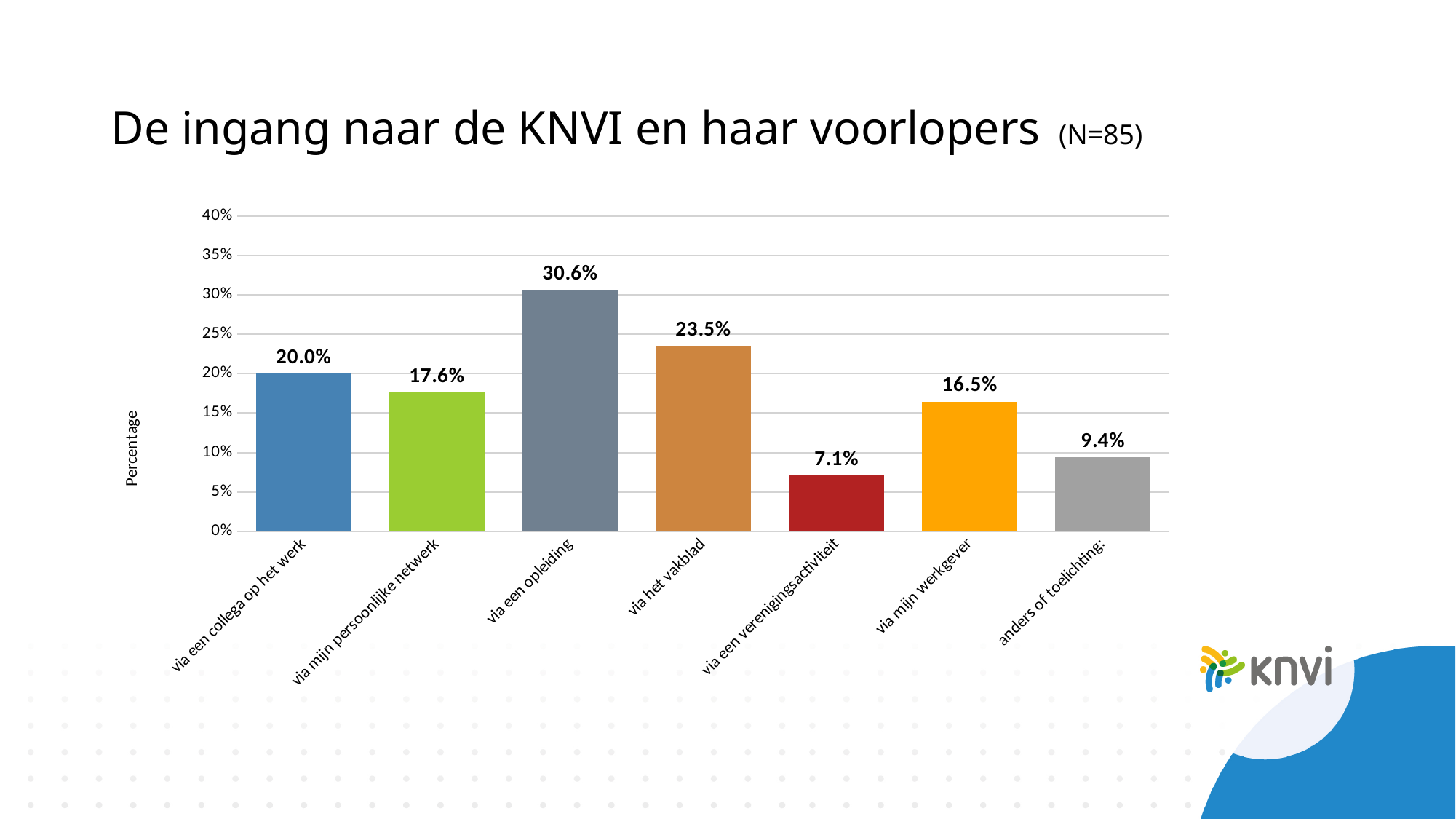
What is the sample size (N) stated in the slide title? 85 What is the value for 'via een verenigingsactiviteit'? 7.1% What percentage is shown for 'via een opleiding'? 30.6% How many categories are shown on the x axis? 7 What is the difference between 'via een opleiding' and 'via het vakblad'? 7.1% Which is larger: 'via een collega op het werk' or 'via mijn persoonlijke netwerk'? via een collega op het werk Which category has the lowest percentage? via een verenigingsactiviteit What percentage is shown for 'via mijn werkgever'? 16.5% What is the label of the vertical axis? Percentage What kind of chart is shown on the slide? bar chart Is the value for 'anders of toelichting:' greater or less than 10%? less Which category has the highest percentage? via een opleiding